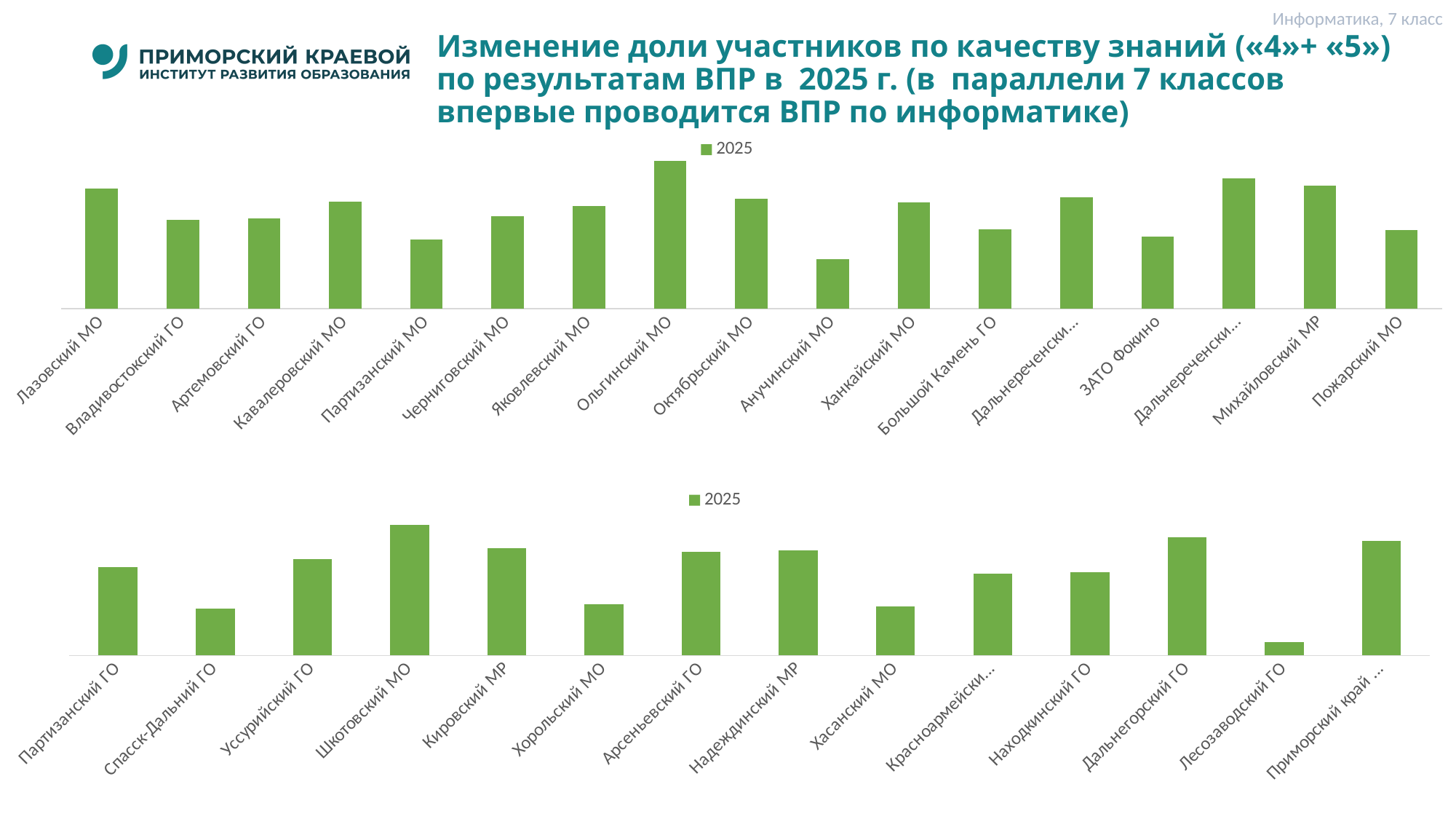
In the bottom chart, which is larger: the value for Дальнегорский ГО or for Хасанский МО? Дальнегорский ГО How many series does the legend of the top chart list? 1 What kind of chart is the top chart on the slide? bar chart In the bottom chart, which category has the lowest bar? Лесозаводский ГО How many categories are shown in the bottom chart? 14 In the bottom chart, which category has the highest bar? Шкотовский МО In the top chart, which category has the lowest bar? Анучинский МО How many categories are shown in the top chart? 17 In the bottom chart, which is larger: the value for Уссурийский ГО or for Спасск-Дальний ГО? Уссурийский ГО In the top chart, which is larger: the value for Лазовский МО or for Партизанский МО? Лазовский МО What is the legend entry shown for the bottom chart? 2025 In the top chart, which category has the highest bar? Ольгинский МО